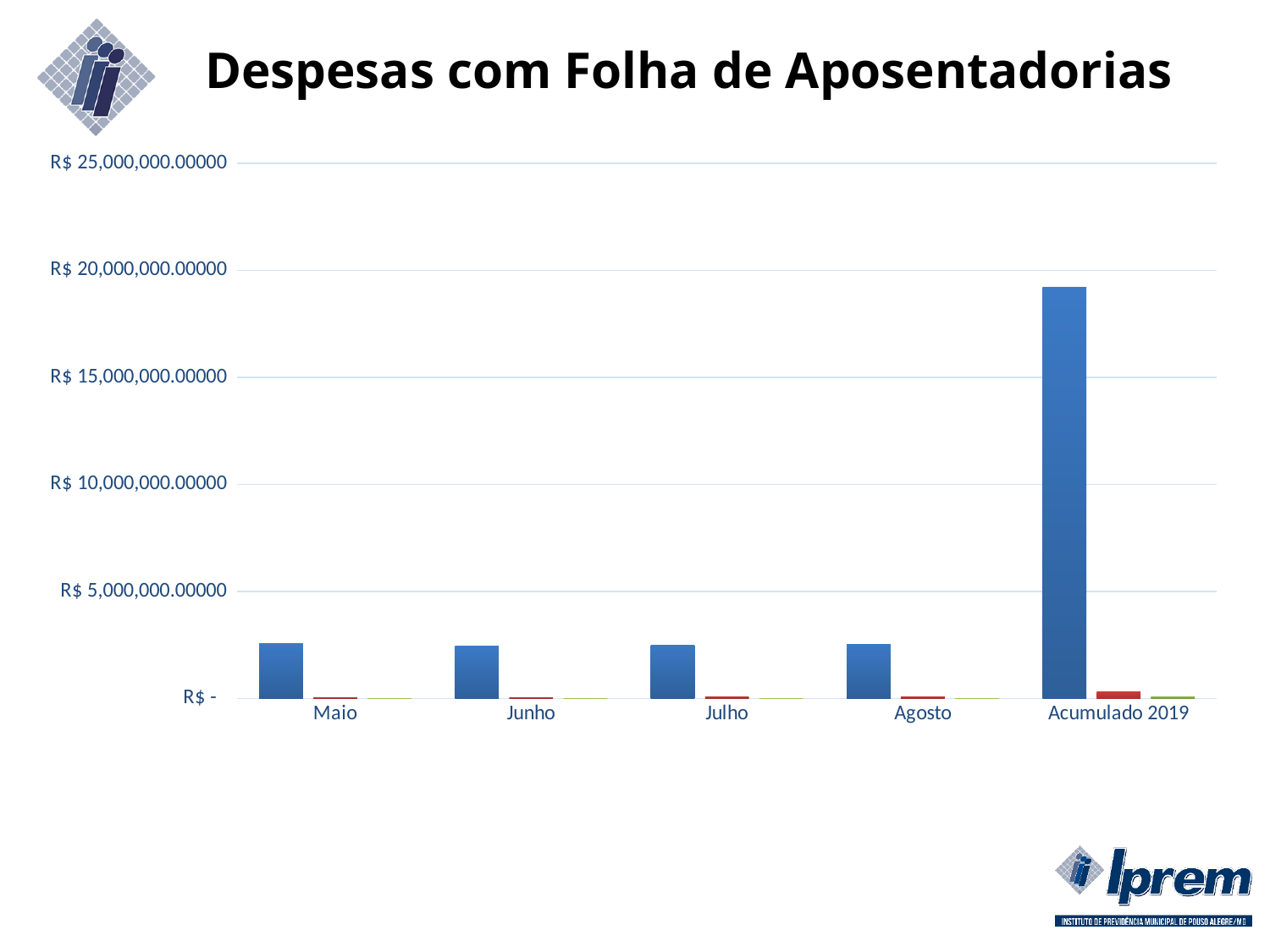
Is the blue bar for Maio greater or less than R$ 5,000,000.00000? less Which has a larger blue bar, Julho or Acumulado 2019? Acumulado 2019 Which category is listed last on the x axis? Acumulado 2019 Which category has the tallest blue bar? Acumulado 2019 How many categories are shown on the x axis of the chart? 5 Is the blue bar for Agosto greater or less than R$ 5,000,000.00000? less What is the highest value labelled on the vertical axis? R$ 25,000,000.00000 Is the blue bar for Acumulado 2019 greater or less than R$ 15,000,000.00000? greater Within the Acumulado 2019 category, which coloured bar is the tallest? blue What kind of chart is shown on the slide? bar chart